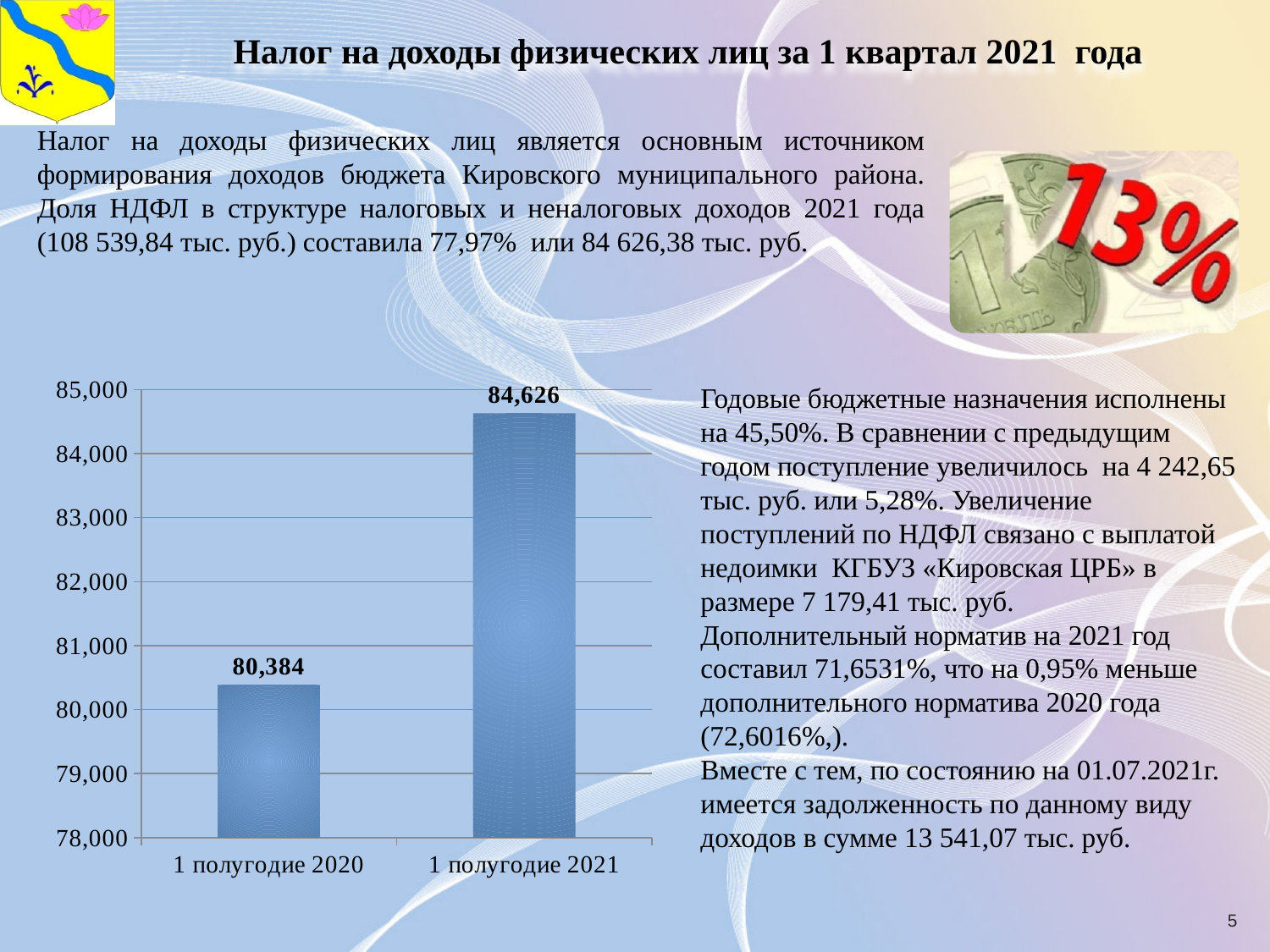
What is the value for 1 полугодие 2021? 84,626 What kind of chart is shown on the slide? bar chart Do the values rise or fall from 1 полугодие 2020 to 1 полугодие 2021? rise What is the difference between the values for 1 полугодие 2021 and 1 полугодие 2020? 4,242 Which category has the lowest value? 1 полугодие 2020 Is the value for 1 полугодие 2021 greater or less than 84,000? greater Is the value for 1 полугодие 2020 greater or less than 81,000? less What is the value for 1 полугодие 2020? 80,384 What is the lowest value shown on the chart's vertical axis? 78,000 Which is larger, the value for 1 полугодие 2020 or 1 полугодие 2021? 1 полугодие 2021 Which category has the highest value? 1 полугодие 2021 How many categories are shown on the chart? 2